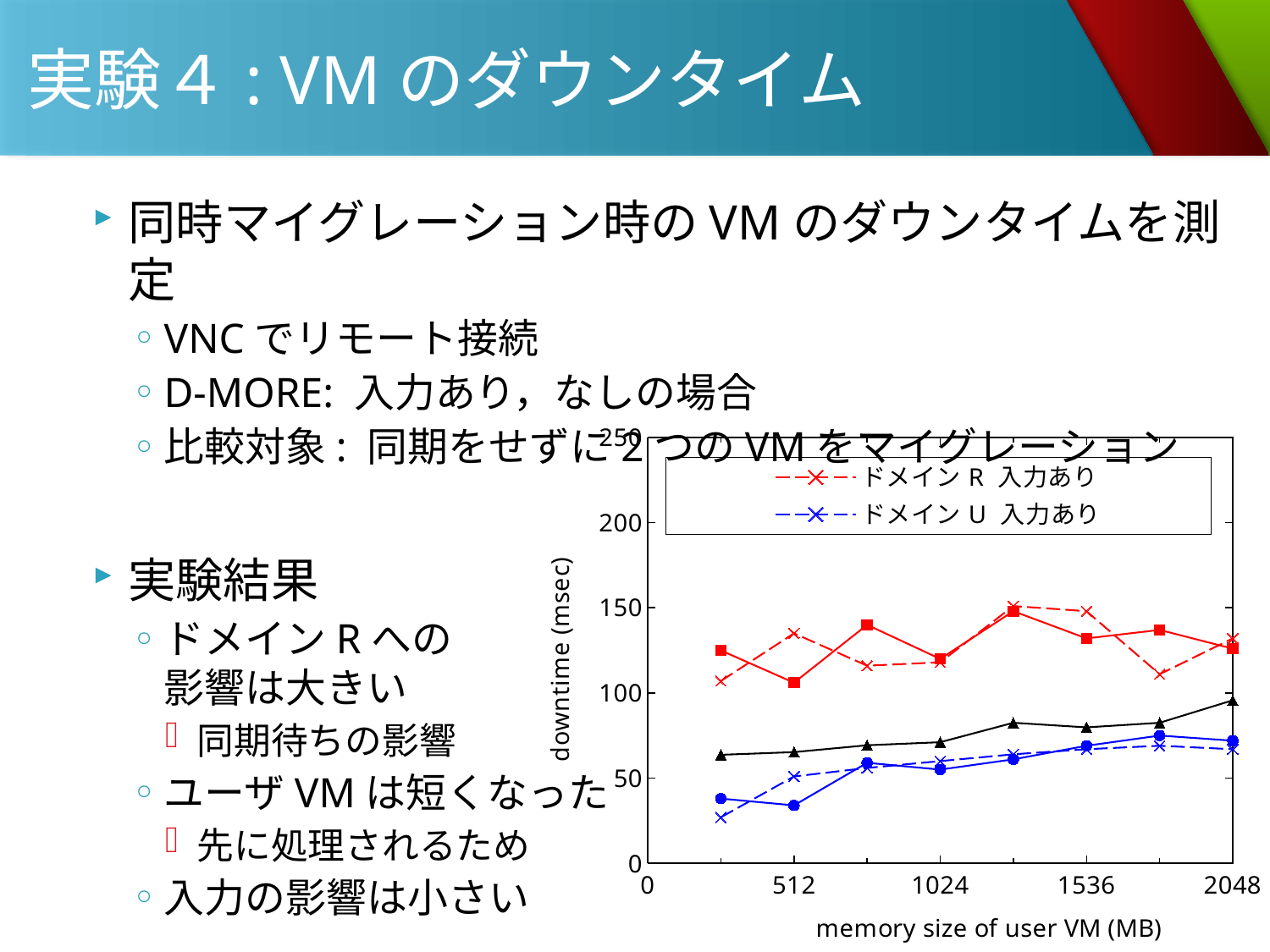
Is the value for ドメイン U 入力あり at 2048 MB greater or less than 100? less Is the value for ドメイン U 入力あり at the smallest memory size (256 MB) greater or less than 50? less At which memory size is the ドメイン U 入力あり series lowest? 256 MB Does the ドメイン U 入力あり series generally rise or fall as memory size increases? rise Is the value for ドメイン R 入力あり at 512 MB greater or less than 100? greater How many data points does the ドメイン U 入力あり series have? 8 What is the label of the x axis of the chart? memory size of user VM (MB) What is the label of the y axis of the chart? downtime (msec) How many series does the chart's legend list? 2 At 1024 MB, which series has the larger downtime: ドメイン R 入力あり or ドメイン U 入力あり? ドメイン R 入力あり What kind of chart is shown on the slide? line chart